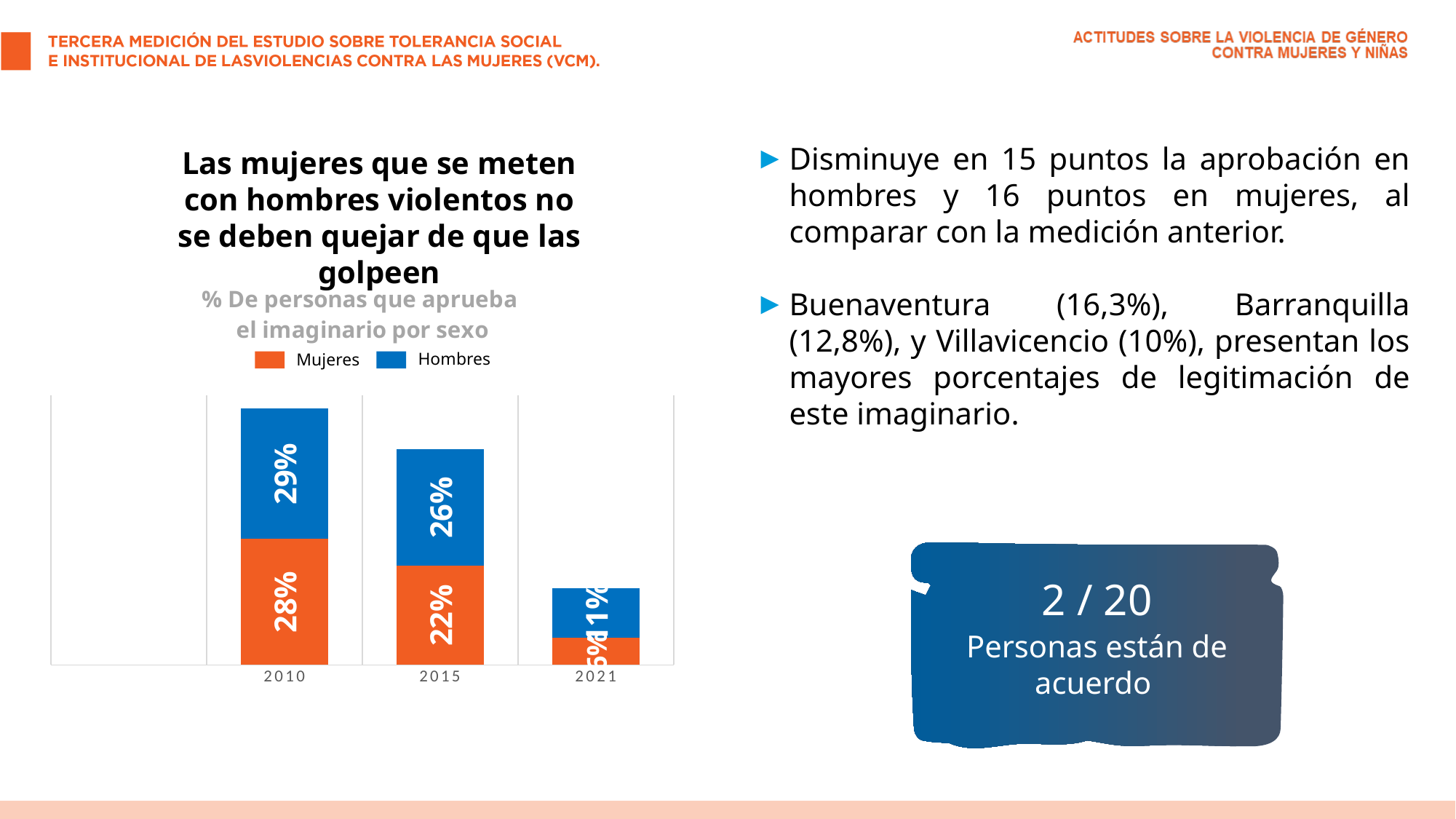
How many years are shown on the x axis of the chart? 3 By how many percentage points did the Mujeres value fall from 2010 to 2015? 6 percentage points Which year has the larger Hombres value, 2010 or 2015? 2010 What is the value for Hombres in 2015? 26% What is the value for Hombres in 2010? 29% Which colour represents Mujeres in the chart legend? Orange Do the stacked bar totals rise or fall from 2010 to 2021? Fall What is the value for Mujeres in 2010? 28% How many series does the chart legend list? 2 What kind of chart is shown on the slide? Stacked bar chart What is the total of the stacked bar for 2010 (Mujeres plus Hombres)? 57% What is the value for Mujeres in 2015? 22%